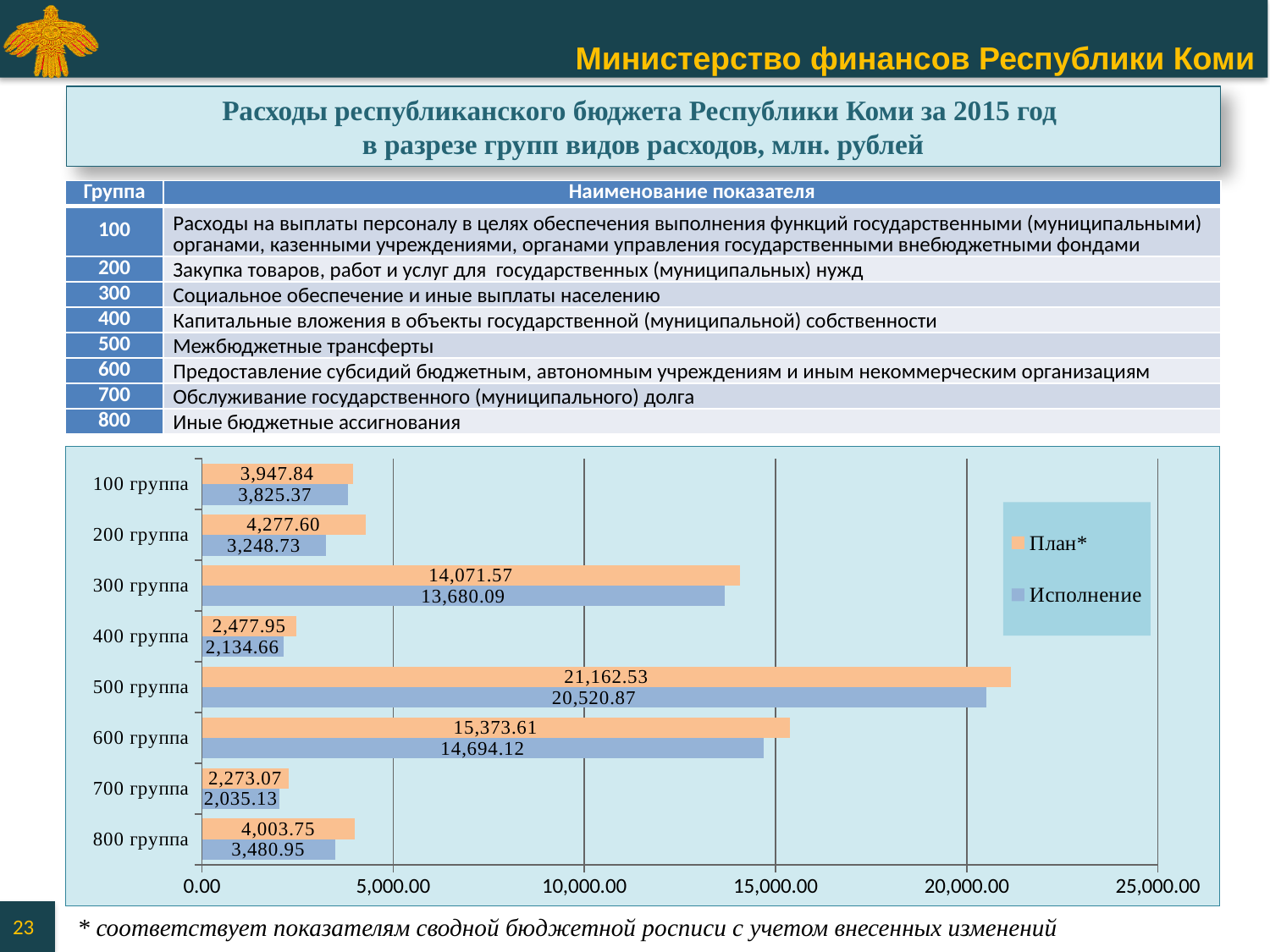
How many series does the chart legend list? 2 What is the difference between the План* and Исполнение values for 500 группа? 641.66 Which is larger, the План* value for 200 группа or the План* value for 800 группа? 200 группа What is the Исполнение value for 700 группа? 2,035.13 What is the План* value for 500 группа? 21,162.53 Which group has the lowest Исполнение value? 700 группа What is the Исполнение value for 300 группа? 13,680.09 What kind of chart is shown on the slide? bar chart Is the Исполнение value for 600 группа greater or less than 10,000.00? greater What is the difference between the План* and Исполнение values for 100 группа? 122.47 How many groups are shown on the chart? 8 Which group has the highest План* value? 500 группа